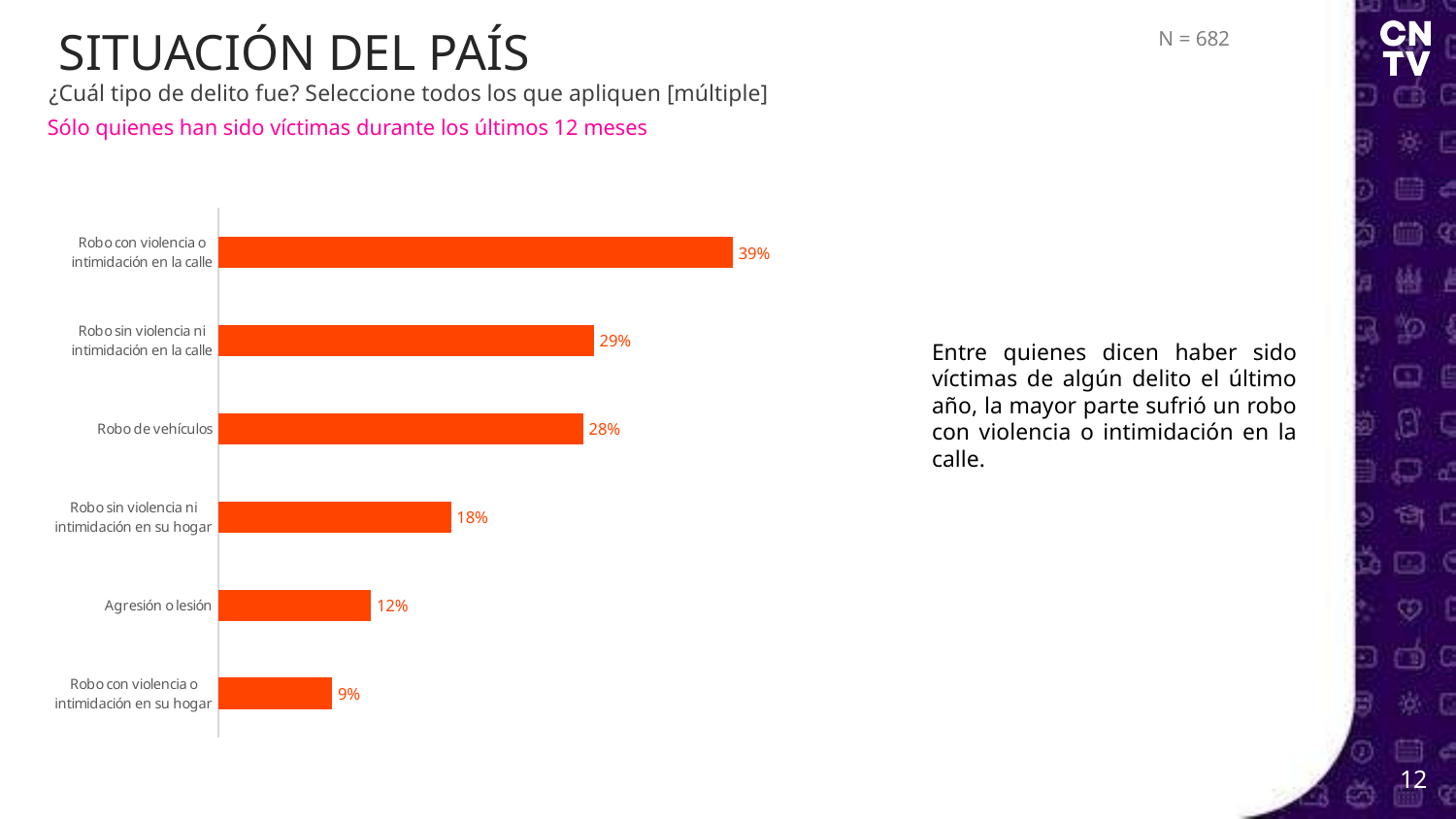
What percentage is shown for "Agresión o lesión"? 12% Which type of crime has the highest percentage? Robo con violencia o intimidación en la calle What colour are the bars in the chart? Orange What is the difference in percentage points between "Robo sin violencia ni intimidación en la calle" and "Robo sin violencia ni intimidación en su hogar"? 11 Which is larger: the value for "Agresión o lesión" or the value for "Robo con violencia o intimidación en su hogar"? Agresión o lesión What percentage is shown for "Robo de vehículos"? 28% What percentage is shown for "Robo con violencia o intimidación en la calle"? 39% What kind of chart is shown on the slide? Bar chart Which type of crime has the lowest percentage? Robo con violencia o intimidación en su hogar How many types of crime are shown in the chart? 6 What percentage is shown for "Robo sin violencia ni intimidación en su hogar"? 18% What is the sample size (N) shown on the slide? 682